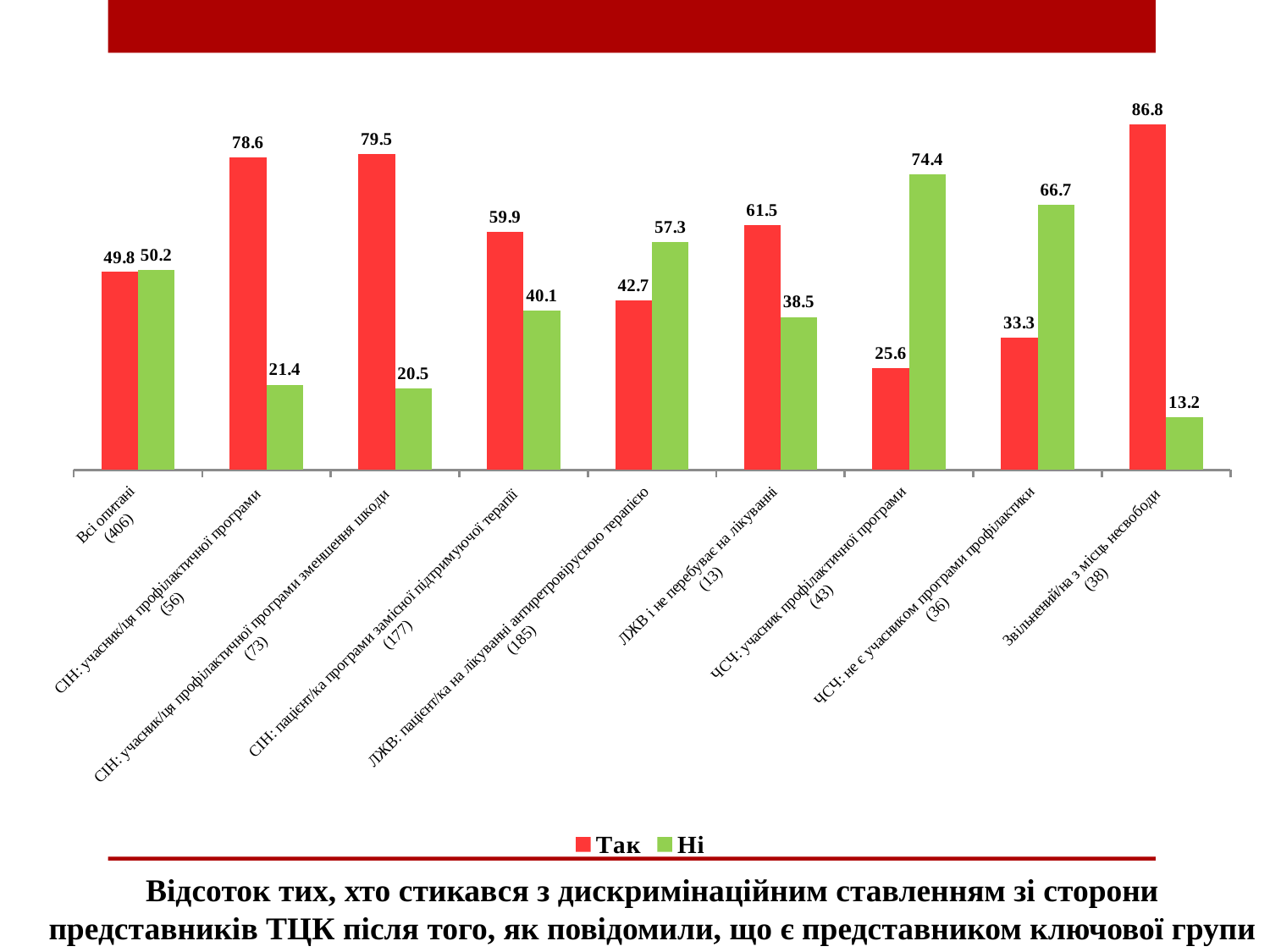
What is the value of "Так" for "Всі опитані (406)"? 49.8 What is the value of "Ні" for "ЧСЧ: учасник профілактичної програми (43)"? 74.4 Which is larger for "ЛЖВ: пацієнт/ка на лікуванні антиретровірусною терапією (185)": the "Так" value or the "Ні" value? Ні How many categories are shown on the x axis? 9 How many series does the legend list? 2 What type of chart is shown on the slide? bar chart Which colour represents the "Ні" series in the legend? green What is the value of "Так" for "ЛЖВ і не перебуває на лікуванні (13)"? 61.5 Which category has the highest "Так" value? Звільнений/на з місць несвободи (38) What is the difference between the "Так" and "Ні" values for "СІН: учасник/ця профілактичної програми (56)"? 57.2 What is the total of the "Так" and "Ні" values for "ЧСЧ: не є учасником програми профілактики (36)"? 100 Which category has the lowest "Ні" value? Звільнений/на з місць несвободи (38)